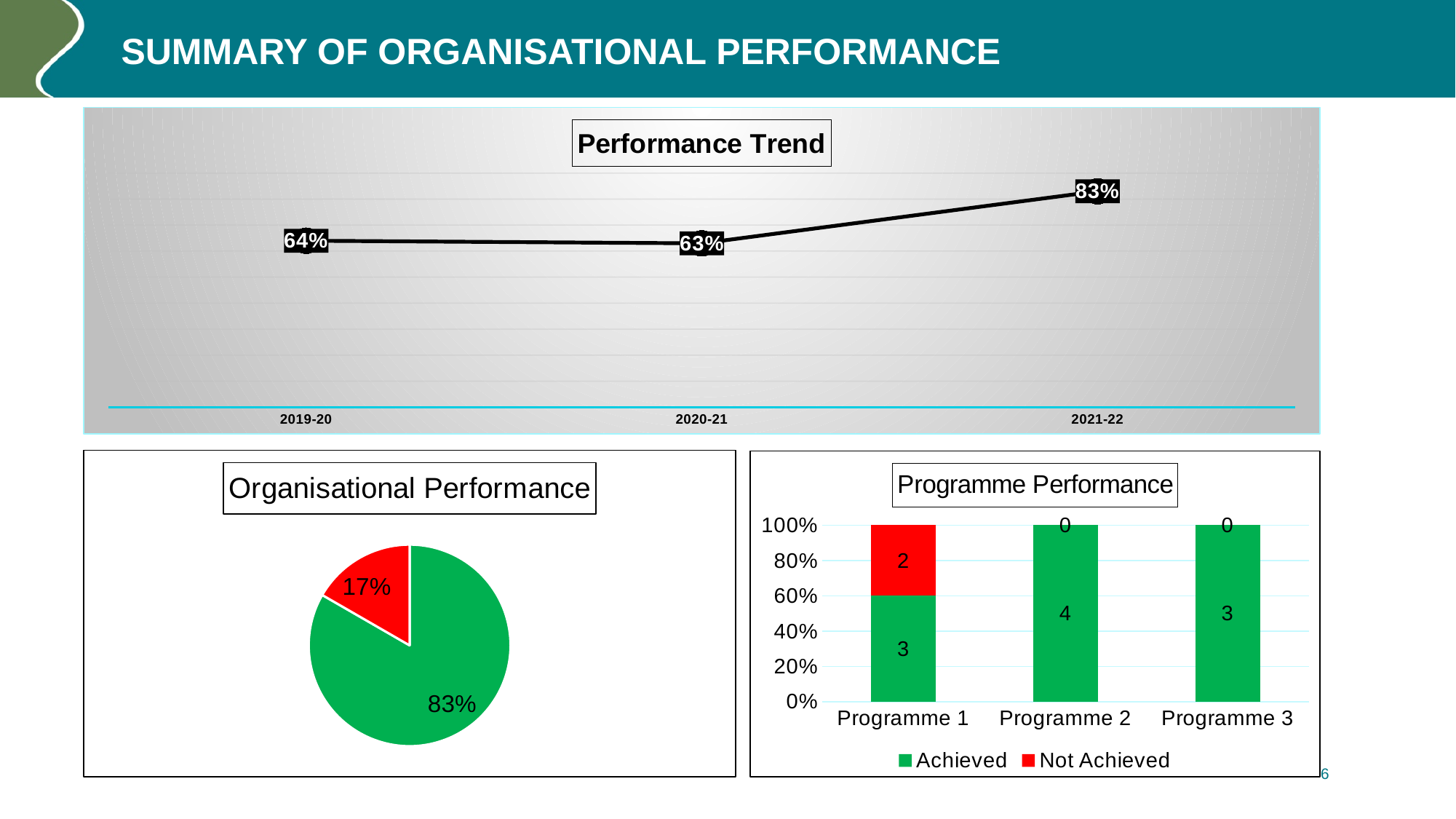
In the Programme Performance chart, how many targets were Not Achieved for Programme 1? 2 In the Performance Trend chart, what is the difference between the 2021-22 and 2020-21 values? 20% In the Organisational Performance chart, what share does the red slice represent? 17% In the Performance Trend chart, how many years are plotted? 3 In the Performance Trend chart, what is the value for 2019-20? 64% In the Performance Trend chart, what is the value for 2021-22? 83% What kind of chart is the Performance Trend chart? Line chart In the Performance Trend chart, which year has the lowest value? 2020-21 In the Programme Performance chart, what is the total number of targets for Programme 1? 5 What kind of chart is the Organisational Performance chart? Pie chart In the Programme Performance chart, how many targets were Achieved for Programme 2? 4 How many series does the legend of the Programme Performance chart list? 2